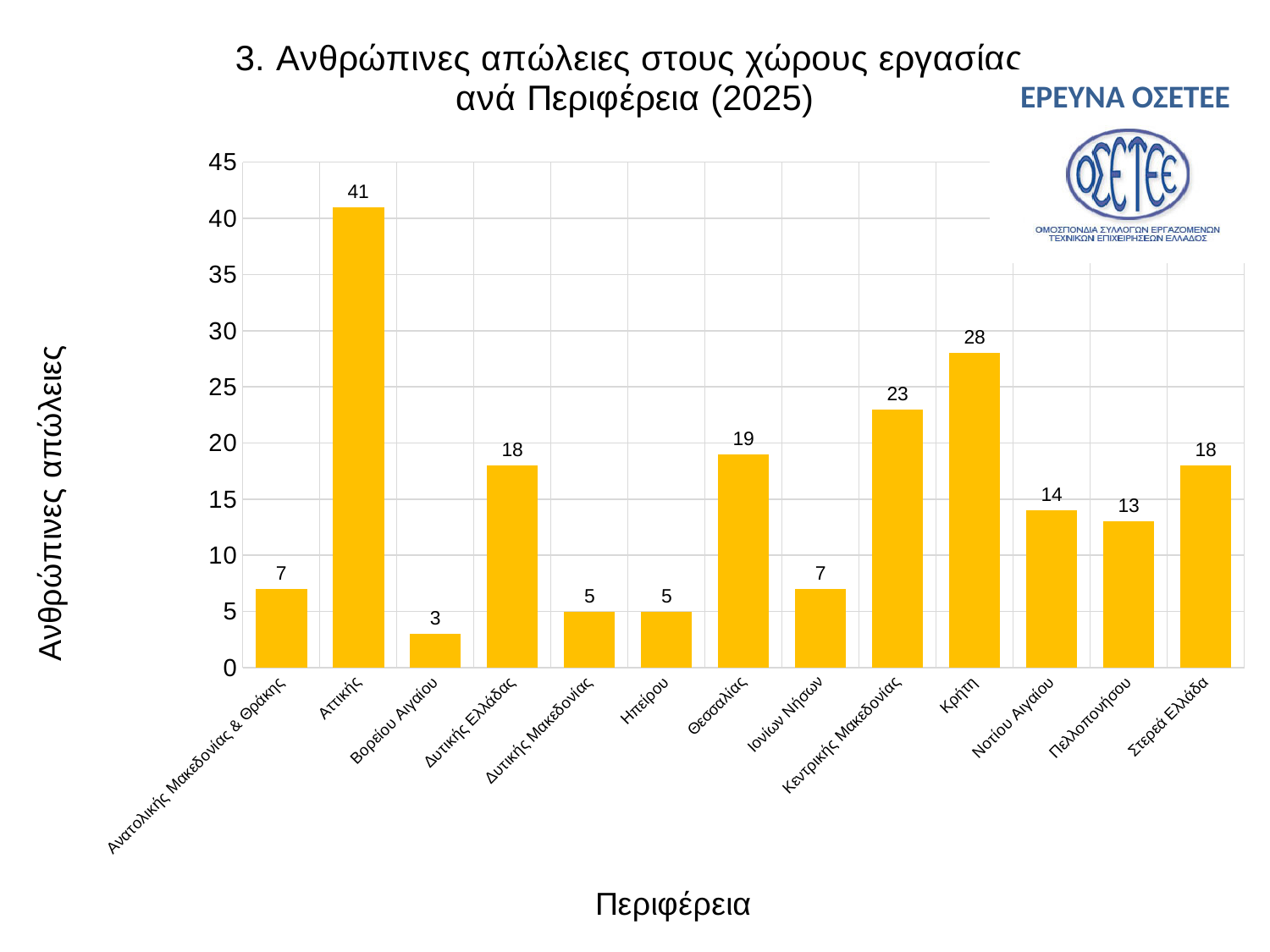
What is the value for Πελοποννήσου? 13 What is the label of the y axis? Ανθρώπινες απώλειες Which is larger, the value for Θεσσαλίας or the value for Νοτίου Αιγαίου? Θεσσαλίας Which region has the lowest value? Βορείου Αιγαίου What kind of chart is this? Bar chart What is the value for Κεντρικής Μακεδονίας? 23 What is the value for Αττικής? 41 What is the value for Κρήτη? 28 What is the title of the chart? 3. Ανθρώπινες απώλειες στους χώρους εργασίας ανά Περιφέρεια (2025) How many regions are shown on the x axis? 13 Which region has the highest value? Αττικής What is the difference between the values for Αττικής and Κρήτη? 13